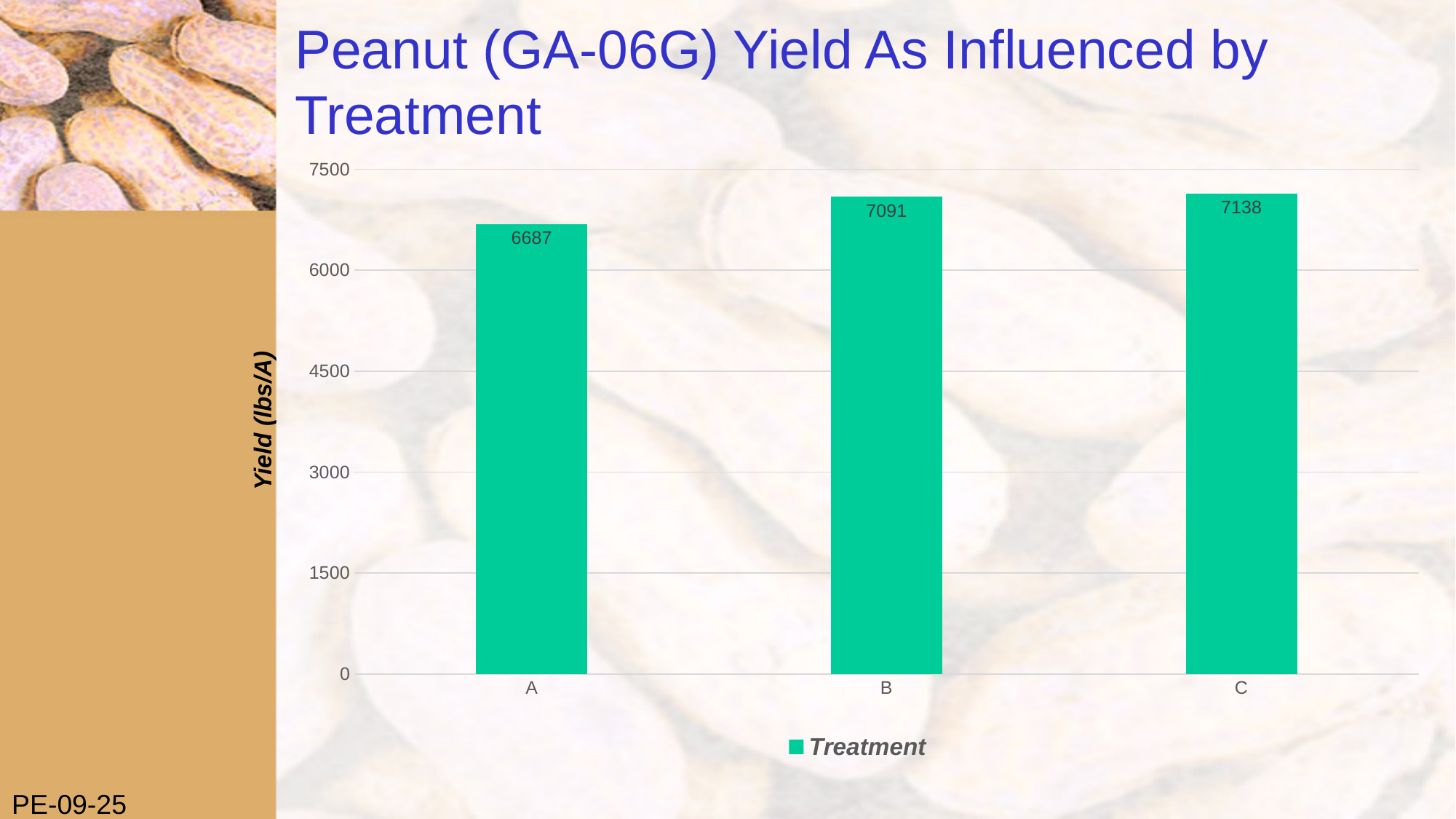
What is the difference in yield between treatment C and treatment A? 451 What is the yield for treatment C? 7138 Is the yield for treatment A greater or less than 6000? greater How many series does the legend list? 1 How many treatments are shown on the chart? 3 What is the label of the y axis? Yield (lbs/A) What is the yield for treatment B? 7091 What is the difference in yield between treatment B and treatment A? 404 What kind of chart is shown on the slide? bar chart Which has a higher yield, treatment A or treatment B? B What is the yield for treatment A? 6687 Which treatment has the lowest yield? A